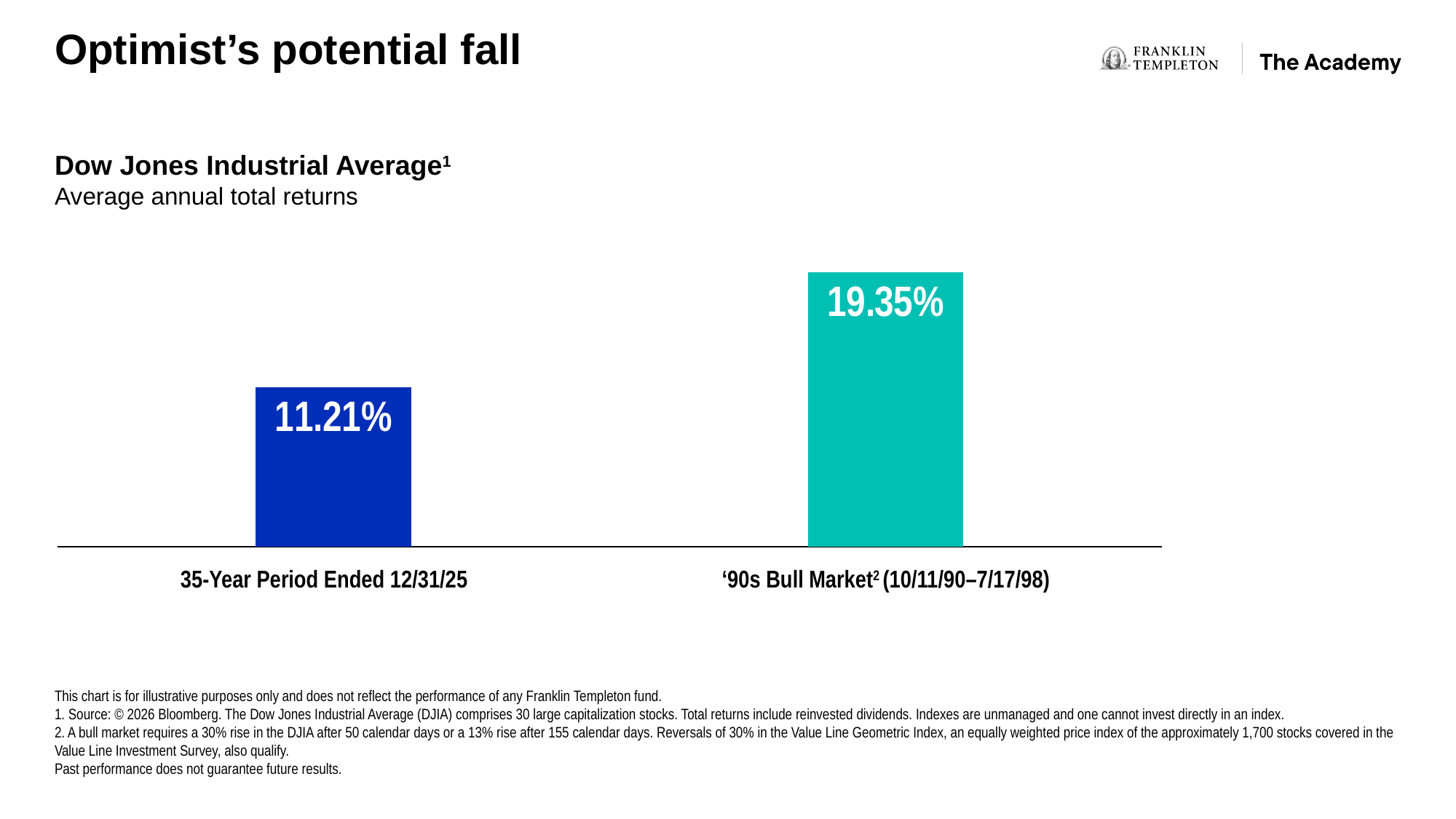
What is the average annual total return for the '90s Bull Market (10/11/90–7/17/98)? 19.35% What colour is the bar for the '90s Bull Market? teal Which period has the higher average annual total return? '90s Bull Market (10/11/90–7/17/98) What is the average annual total return for the 35-Year Period Ended 12/31/25? 11.21% What index does the chart show average annual total returns for? Dow Jones Industrial Average Is the return for the 35-Year Period Ended 12/31/25 larger or smaller than the return for the '90s Bull Market? smaller What is the difference between the '90s Bull Market return and the 35-Year Period return? 8.14% Which period has the lower average annual total return? 35-Year Period Ended 12/31/25 What kind of chart is shown on the slide? bar chart How many periods (bars) are shown in the chart? 2